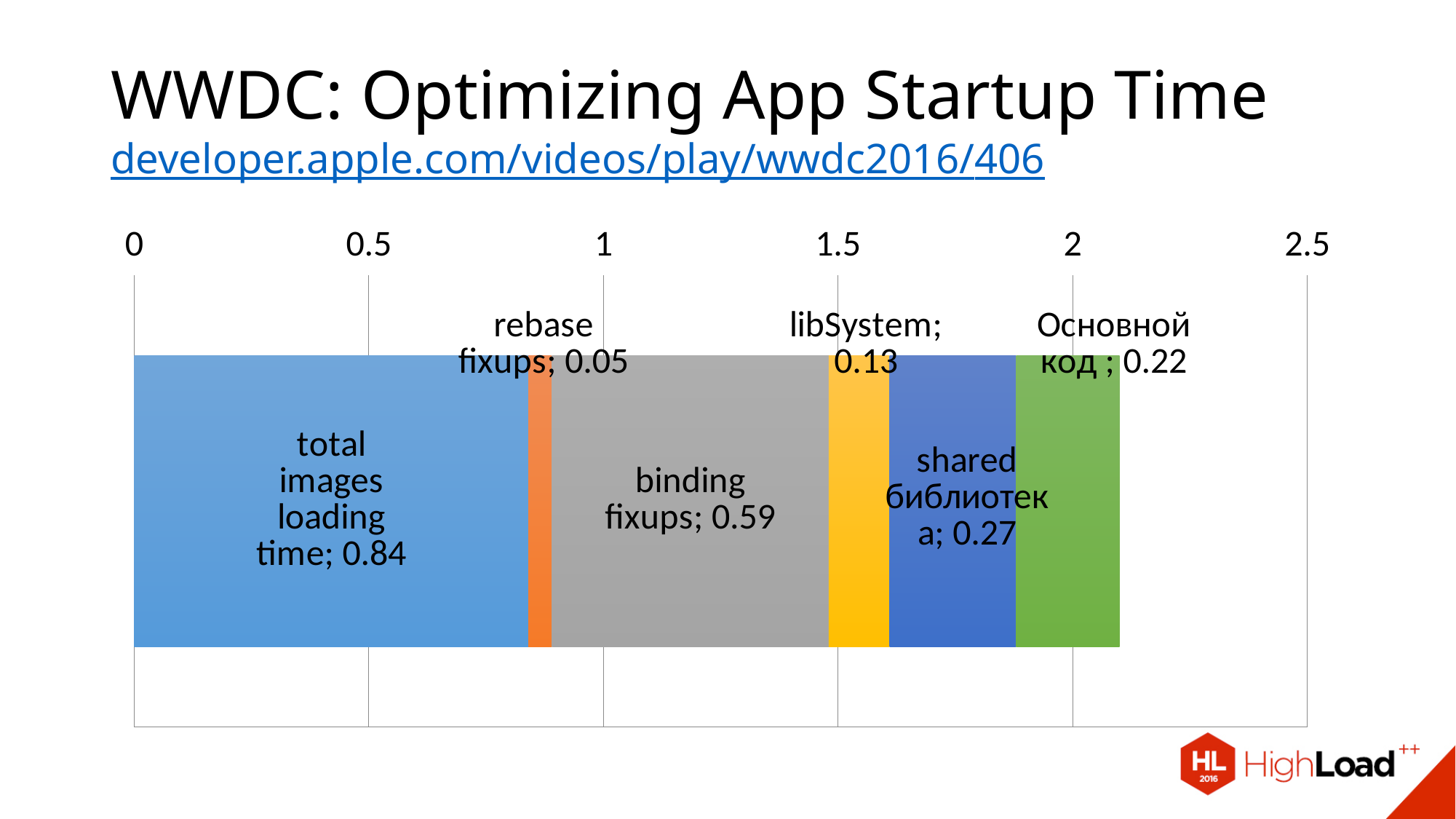
What is the value of the "libSystem" segment? 0.13 What kind of chart is shown on the slide? Stacked bar chart What is the value of the "binding fixups" segment? 0.59 What is the value of the "total images loading time" segment? 0.84 Which segment of the bar has the smallest value? rebase fixups Which segment of the bar has the largest value? total images loading time Which is larger, the "shared библиотека" value or the "Основной код" value? shared библиотека How many segments make up the stacked bar? 6 What is the value of the "Основной код" segment? 0.22 What is the total of all segments in the stacked bar? 2.1 What is the value of the "rebase fixups" segment? 0.05 What is the difference between the "total images loading time" and "binding fixups" values? 0.25